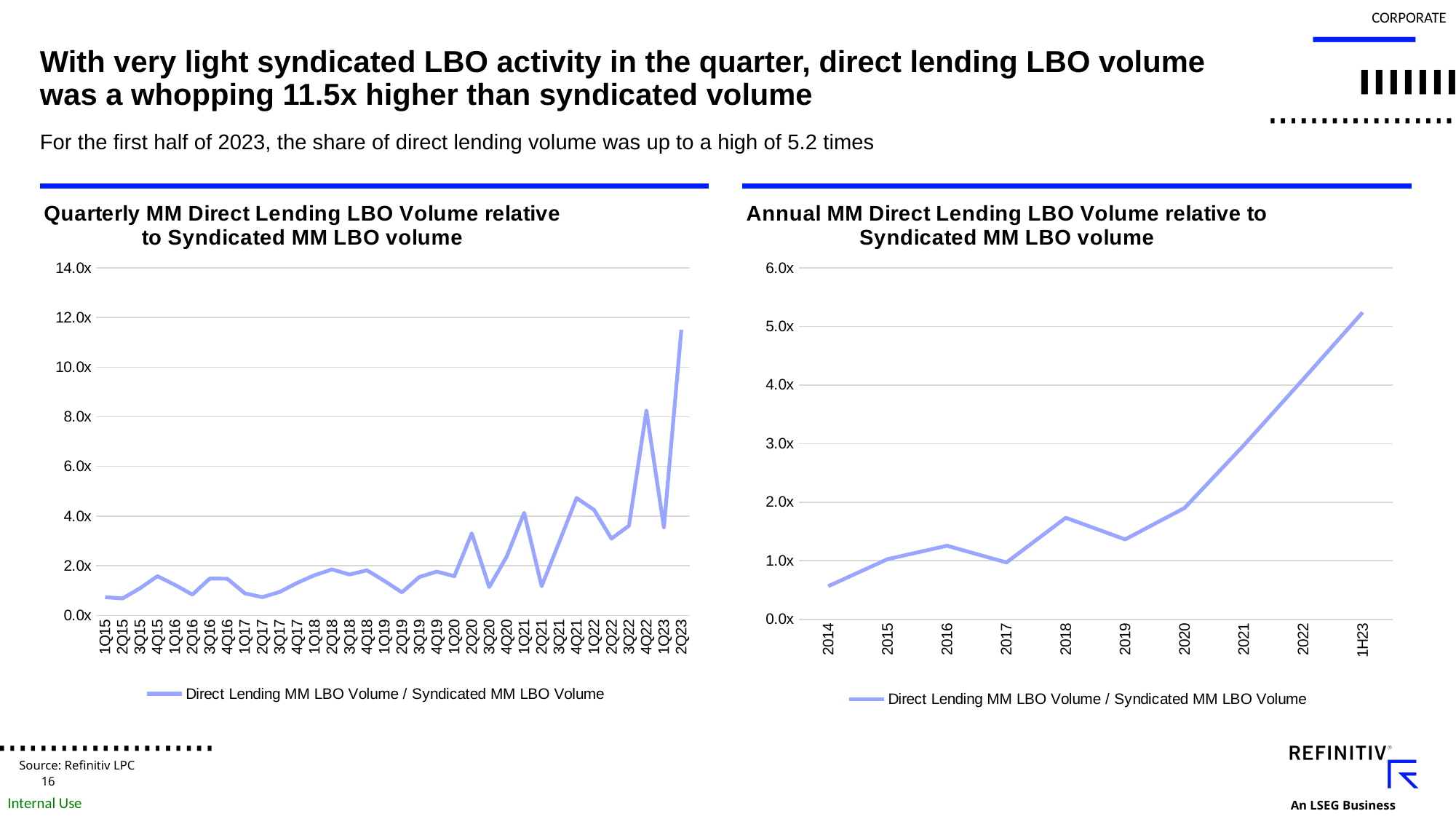
In the left chart (Quarterly), is the value for 1Q23 greater or less than 4.0x? less In the right chart (Annual), how many periods are shown on the x axis? 10 In the right chart (Annual), is the value for 2014 greater or less than 1.0x? less What kind of chart is the right chart, 'Annual MM Direct Lending LBO Volume relative to Syndicated MM LBO volume'? Line chart In the left chart (Quarterly), is the value for 2Q23 greater or less than 10.0x? greater In the left chart (Quarterly), how many series does the legend list? 1 In the right chart (Annual), which period has the lowest value? 2014 What kind of chart is the left chart, 'Quarterly MM Direct Lending LBO Volume relative to Syndicated MM LBO volume'? Line chart In the right chart (Annual), which period has the highest value? 1H23 In the left chart (Quarterly), which quarter has the highest value? 2Q23 In the right chart (Annual), do the values generally rise or fall from 2014 to 1H23? Rise